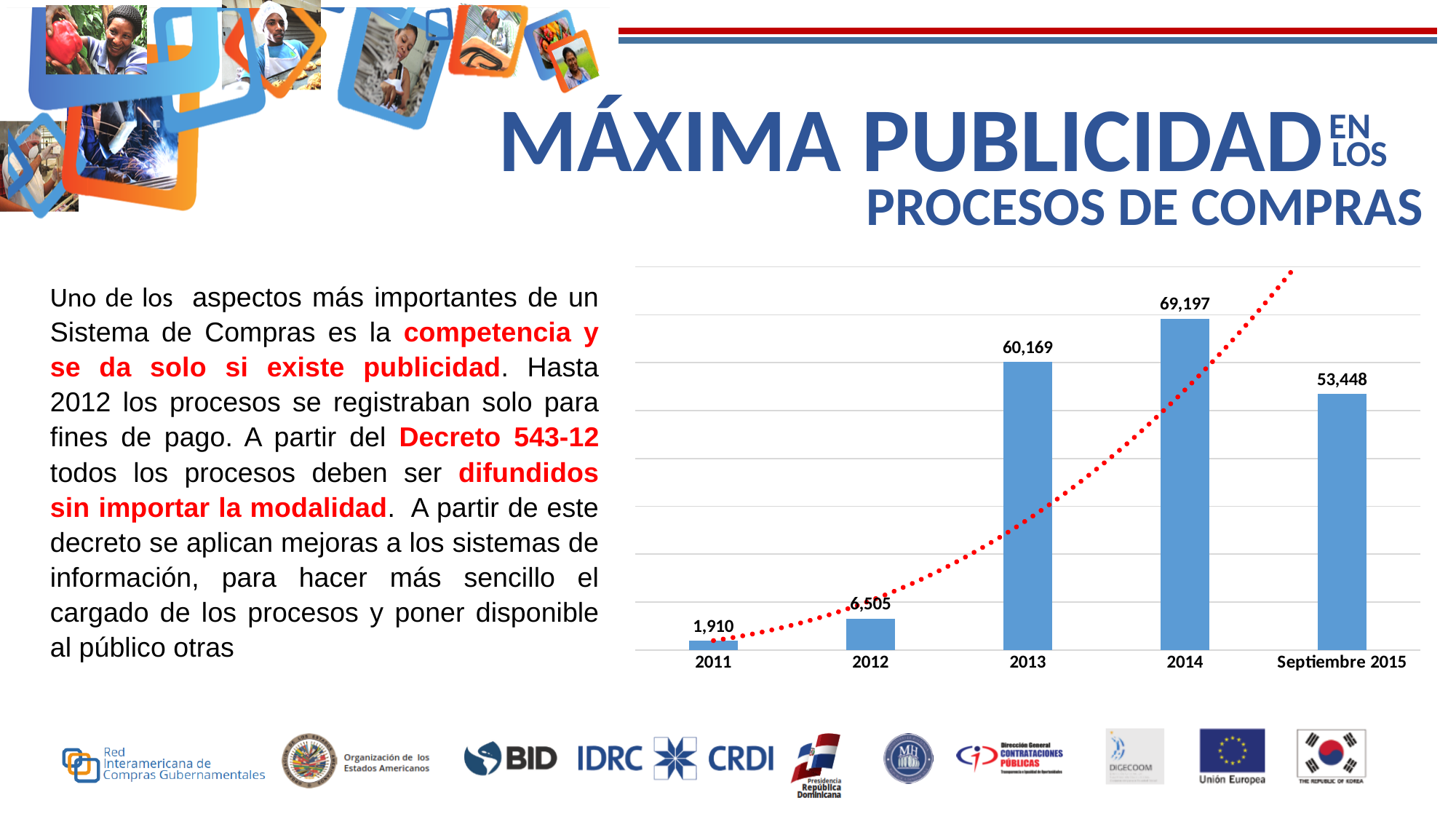
What is the value shown for Septiembre 2015? 53,448 What is the difference between the values for 2012 and 2011? 4,595 What kind of chart is shown on the slide? Bar chart How many bars are shown in the chart? 5 Which year has the highest value? 2014 Which is larger, the value for 2014 or the value for Septiembre 2015? 2014 What is the difference between the values for 2014 and 2013? 9,028 What is the value shown for 2011? 1,910 What colour is the dotted trend line overlaid on the bars? Red What is the value shown for 2013? 60,169 Which year has the lowest value? 2011 Do the values rise or fall from 2011 to 2014? Rise